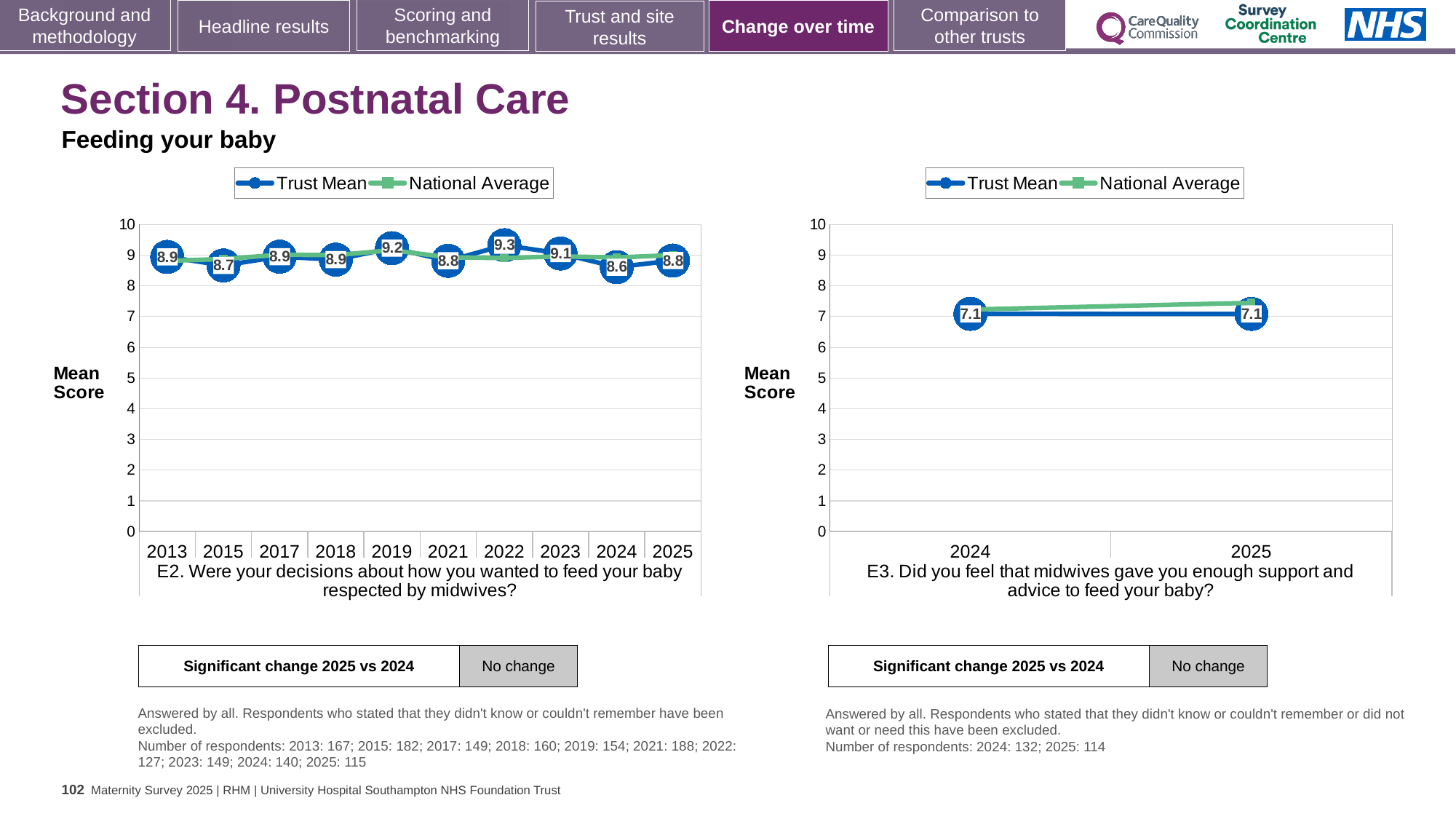
In the left chart (E2), how many years are plotted on the x axis? 10 In the left chart (E2), what is the Trust Mean for 2022? 9.3 In the right chart (E3), what is the Trust Mean for 2025? 7.1 In the left chart (E2), what is the Trust Mean for 2015? 8.7 In the right chart (E3), how many series does the legend list? 2 What kind of chart is the left chart (E2)? Line chart In the left chart (E2), does the Trust Mean rise or fall from 2024 to 2025? Rise In the right chart (E3), is the Trust Mean for 2024 greater or less than 8? less In the left chart (E2), which year has the highest Trust Mean? 2022 In the left chart (E2), which year has the lowest Trust Mean? 2024 In the left chart (E2), what is the difference between the Trust Mean in 2022 and in 2024? 0.7 In the left chart (E2), is the Trust Mean higher in 2019 or in 2021? 2019